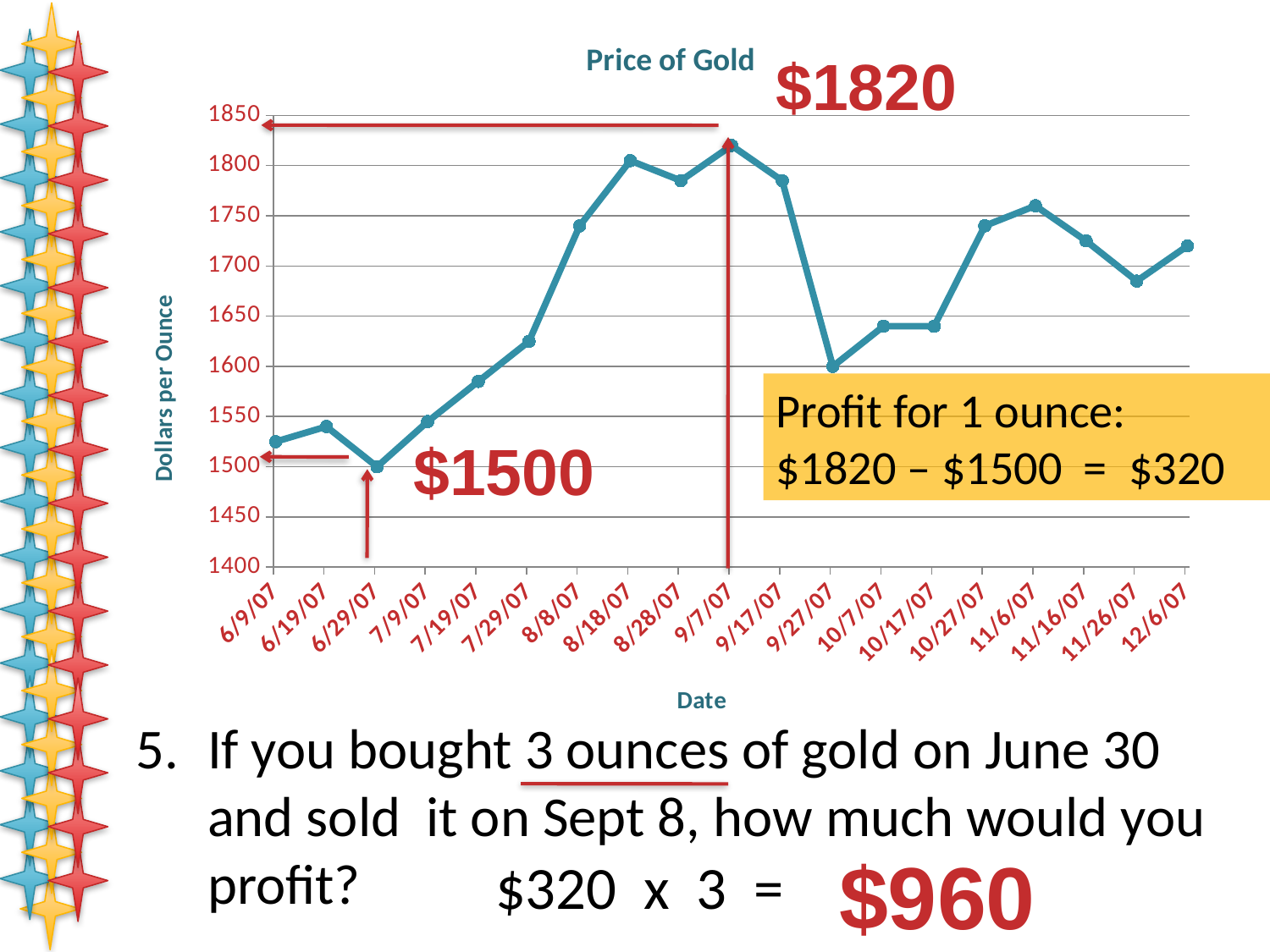
Does the price of gold rise or fall between 6/29/07 and 9/7/07? rise Is the price of gold on 9/27/07 greater or less than 1650? less What kind of chart is shown on the slide? line chart On which date does the price of gold reach its highest value? 9/7/07 What is the price of gold on 9/7/07 according to the chart annotation? $1820 What is the price of gold on 6/29/07 according to the chart annotation? $1500 On which date does the price of gold reach its lowest value? 6/29/07 How many data points are plotted on the chart? 19 What is the difference between the price on 9/7/07 and the price on 6/29/07? $320 What is the title of the chart? Price of Gold Is the price of gold on 8/18/07 greater or less than 1750? greater What is the label on the vertical axis of the chart? Dollars per Ounce